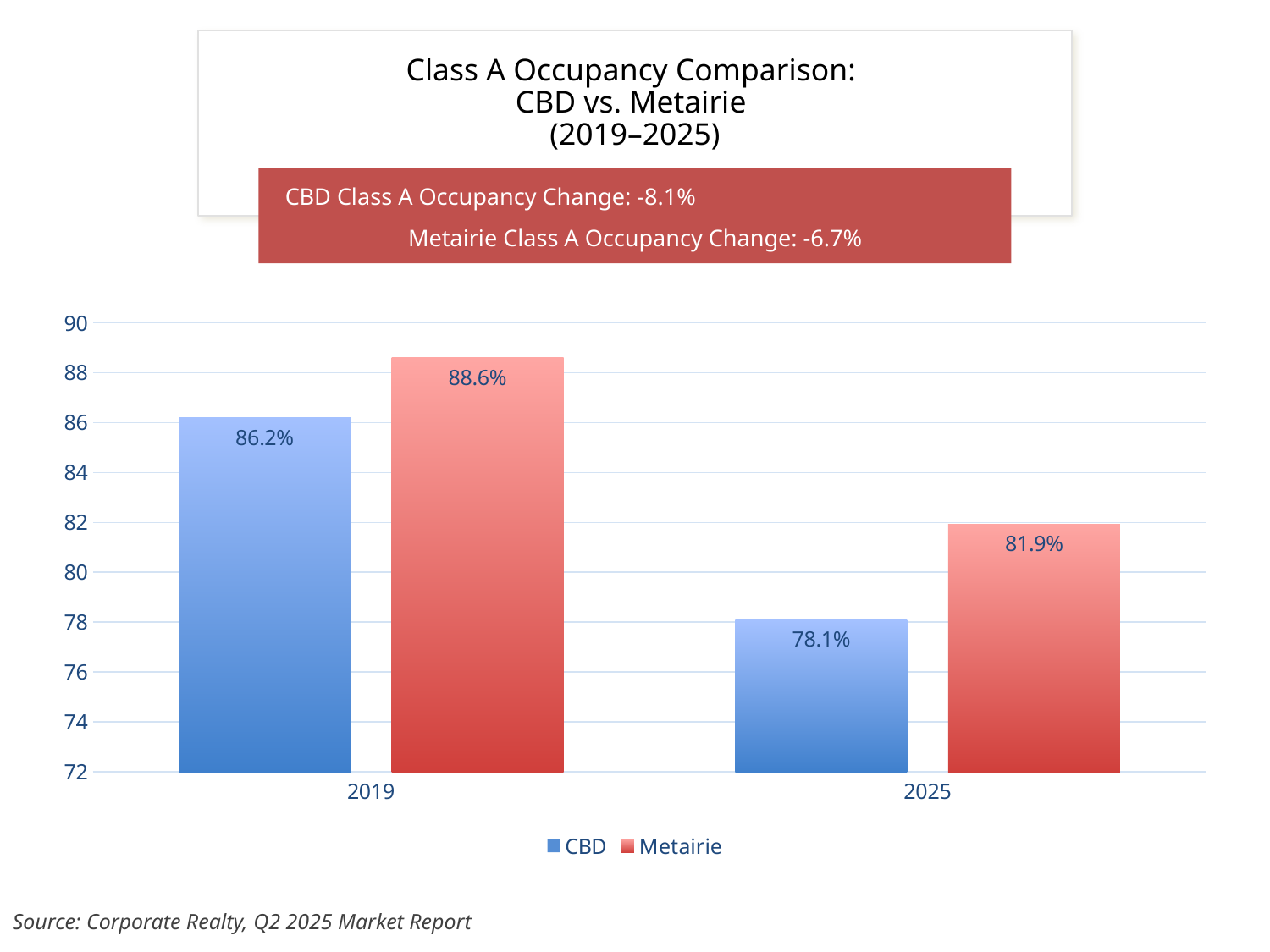
What is the CBD Class A occupancy value for 2025? 78.1% What is the difference between the Metairie and CBD occupancy values in 2019? 2.4% Which bar shows the lowest occupancy value on the chart? CBD 2025 Is the CBD occupancy value for 2025 greater or less than 80? less What is the CBD Class A occupancy value for 2019? 86.2% Does the CBD occupancy rise or fall from 2019 to 2025? Fall Which is larger in 2025, the CBD occupancy or the Metairie occupancy? Metairie What kind of chart is shown on the slide? Bar chart What is the difference between the Metairie and CBD occupancy values in 2025? 3.8% How many series does the legend list? 2 Which bar shows the highest occupancy value on the chart? Metairie 2019 What is the Metairie Class A occupancy value for 2025? 81.9%